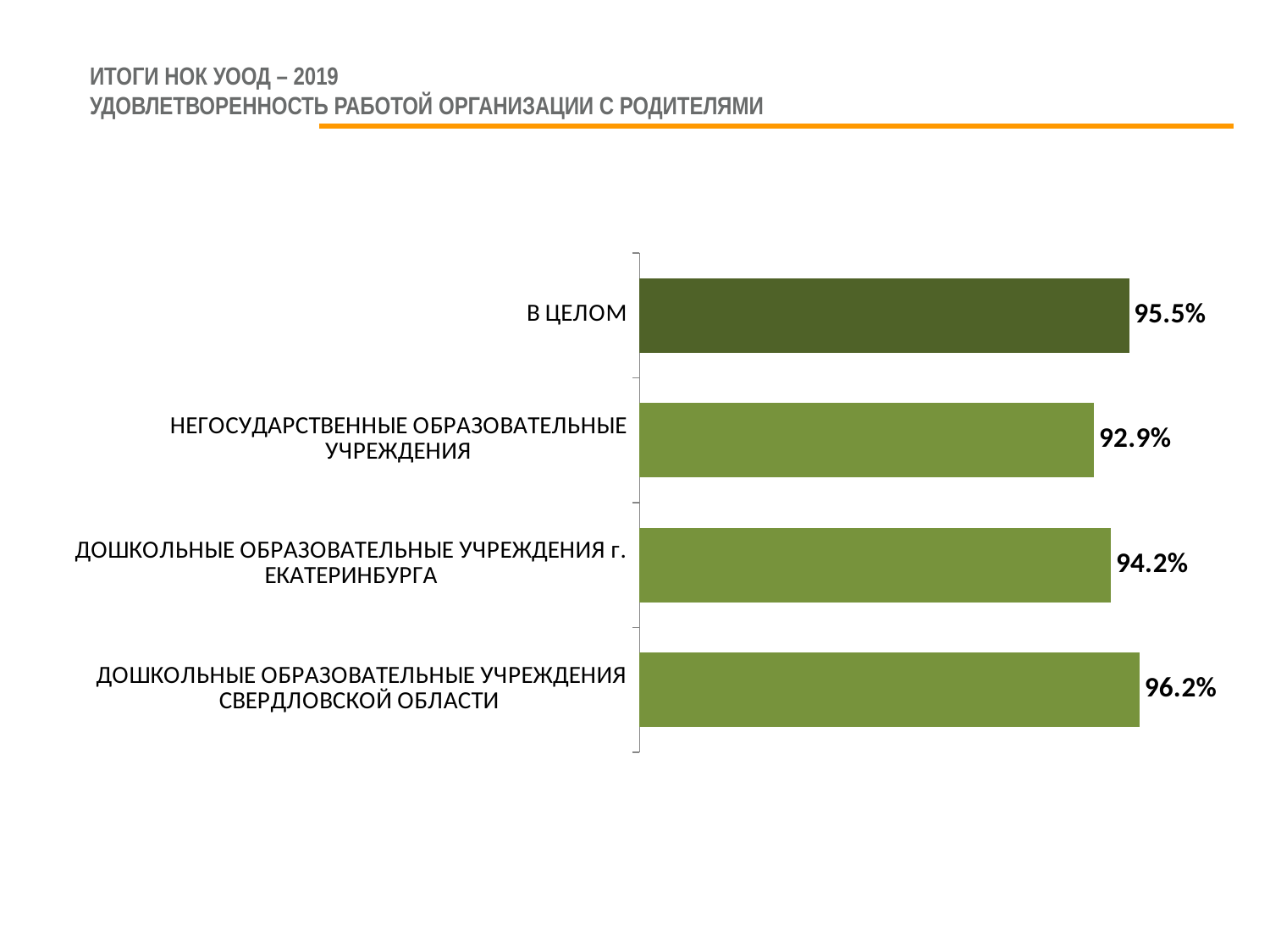
What is the value for ДОШКОЛЬНЫЕ ОБРАЗОВАТЕЛЬНЫЕ УЧРЕЖДЕНИЯ СВЕРДЛОВСКОЙ ОБЛАСТИ? 96.2% Which category has the lowest value? НЕГОСУДАРСТВЕННЫЕ ОБРАЗОВАТЕЛЬНЫЕ УЧРЕЖДЕНИЯ How many categories are shown in the chart? 4 What is the difference between the values for В ЦЕЛОМ and ДОШКОЛЬНЫЕ ОБРАЗОВАТЕЛЬНЫЕ УЧРЕЖДЕНИЯ г. ЕКАТЕРИНБУРГА? 1.3% What is the difference between the values for ДОШКОЛЬНЫЕ ОБРАЗОВАТЕЛЬНЫЕ УЧРЕЖДЕНИЯ СВЕРДЛОВСКОЙ ОБЛАСТИ and НЕГОСУДАРСТВЕННЫЕ ОБРАЗОВАТЕЛЬНЫЕ УЧРЕЖДЕНИЯ? 3.3% What is the value for В ЦЕЛОМ? 95.5% Which is larger: the value for В ЦЕЛОМ or the value for ДОШКОЛЬНЫЕ ОБРАЗОВАТЕЛЬНЫЕ УЧРЕЖДЕНИЯ г. ЕКАТЕРИНБУРГА? В ЦЕЛОМ Which category has the highest value? ДОШКОЛЬНЫЕ ОБРАЗОВАТЕЛЬНЫЕ УЧРЕЖДЕНИЯ СВЕРДЛОВСКОЙ ОБЛАСТИ What is the title of the slide? ИТОГИ НОК УООД – 2019 УДОВЛЕТВОРЕННОСТЬ РАБОТОЙ ОРГАНИЗАЦИИ С РОДИТЕЛЯМИ What kind of chart is shown on the slide? Bar chart What is the value for НЕГОСУДАРСТВЕННЫЕ ОБРАЗОВАТЕЛЬНЫЕ УЧРЕЖДЕНИЯ? 92.9% What is the value for ДОШКОЛЬНЫЕ ОБРАЗОВАТЕЛЬНЫЕ УЧРЕЖДЕНИЯ г. ЕКАТЕРИНБУРГА? 94.2%